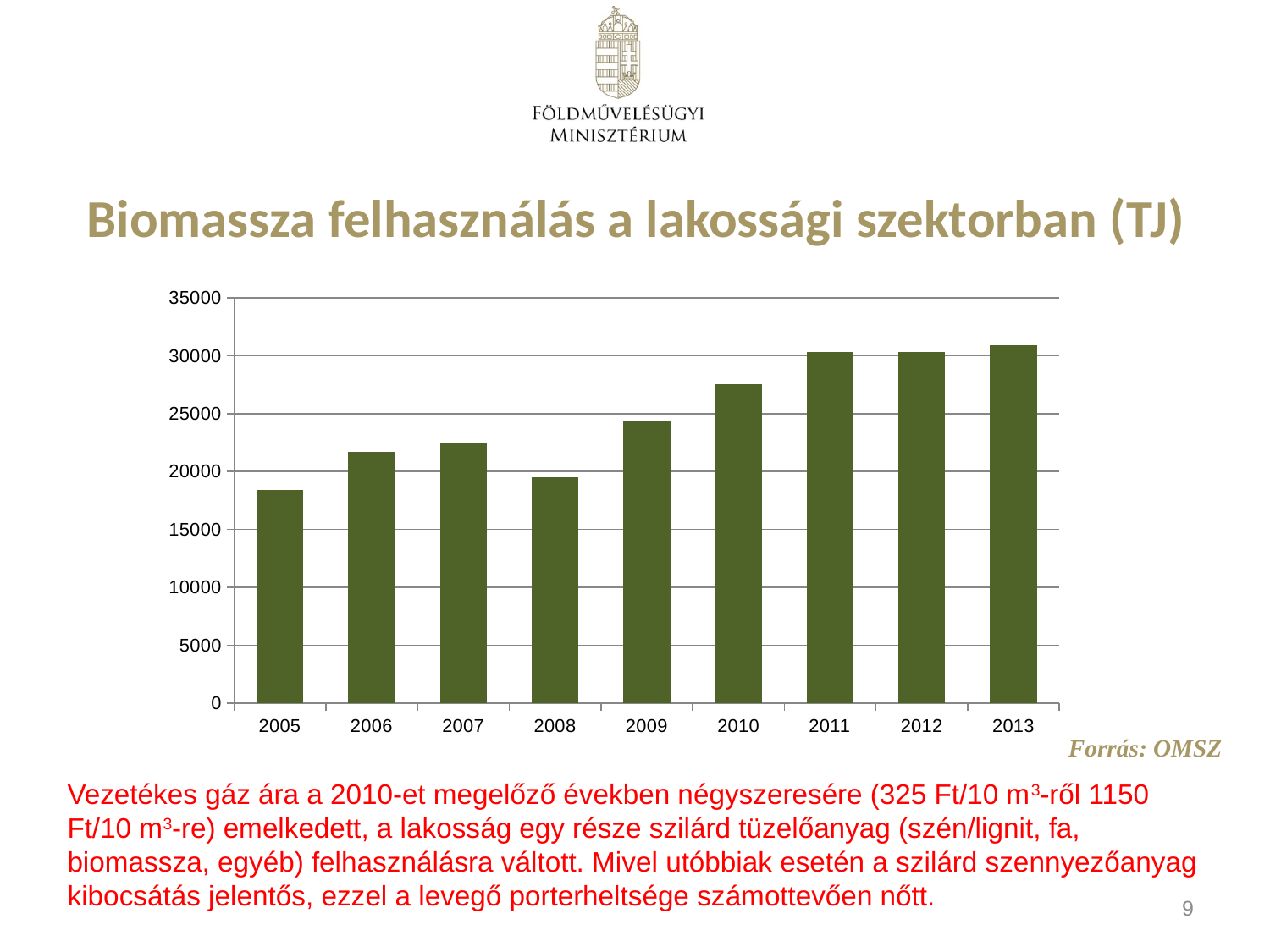
Which year has the larger value, 2009 or 2010? 2010 Do the values generally rise or fall from 2005 to 2013? rise Is the value for 2008 greater or less than 20000? less Is the value for 2006 greater or less than 20000? greater Is the value for 2005 greater or less than 20000? less What is the title of the chart? Biomassza felhasználás a lakossági szektorban (TJ) Which year has the larger value, 2007 or 2008? 2007 Which year has the lowest value in the chart? 2005 What kind of chart is shown on the slide? bar chart How many years are shown on the x axis of the chart? 9